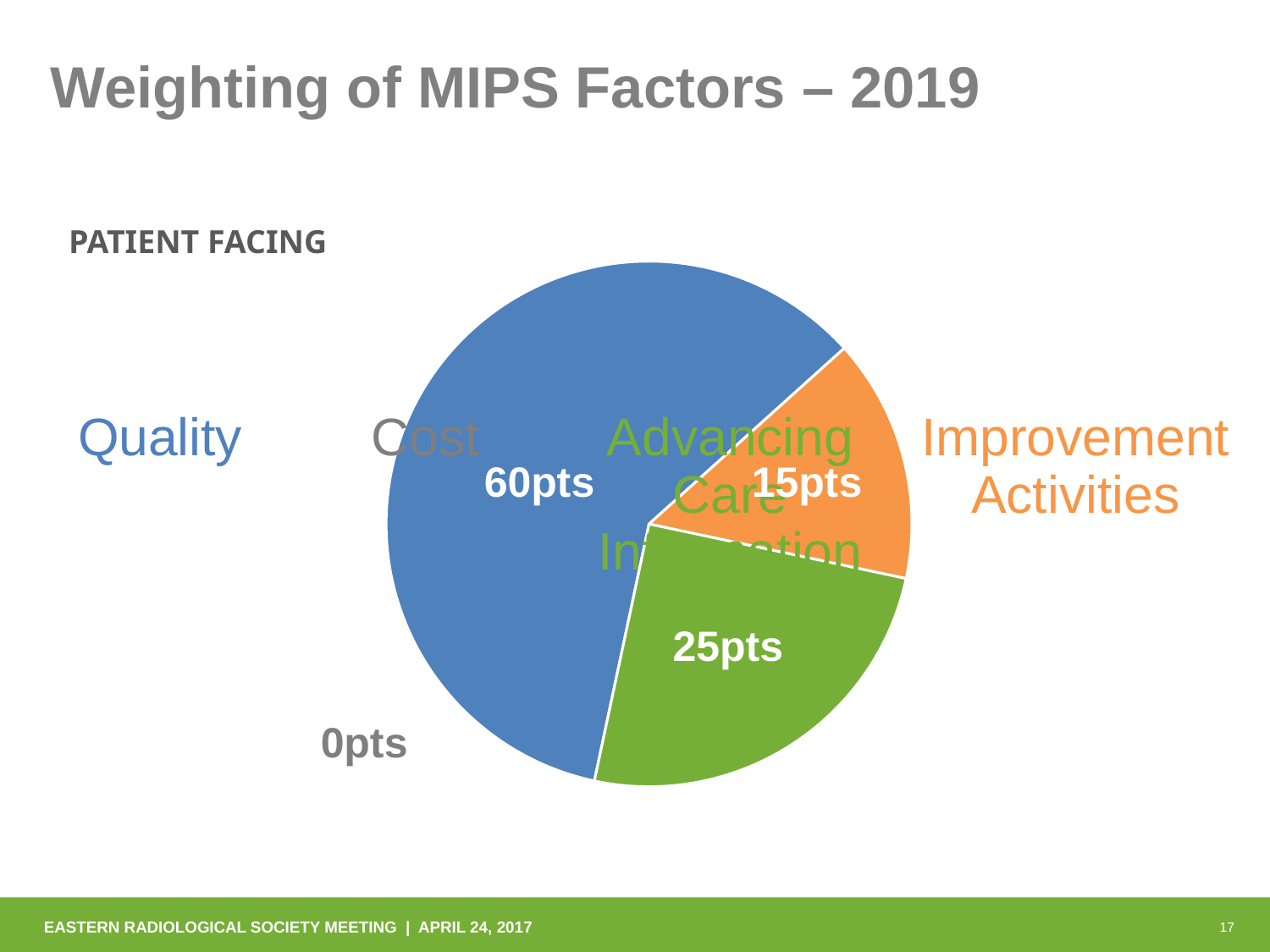
What share of the total points does Quality represent? 60% How many slices does the pie chart have? 3 How many points is Cost worth according to the slide? 0pts Which slice of the pie chart is the smallest? Improvement Activities What is the difference in points between Quality and Improvement Activities? 45pts How many points is Quality worth in the pie chart? 60pts How many points is Improvement Activities worth in the pie chart? 15pts What value is labelled on the green slice of the pie chart? 25pts What is the title of the slide? Weighting of MIPS Factors – 2019 Which is larger, the Quality slice or the green slice? Quality Which factor has the largest slice of the pie chart? Quality What kind of chart is shown on the slide? Pie chart